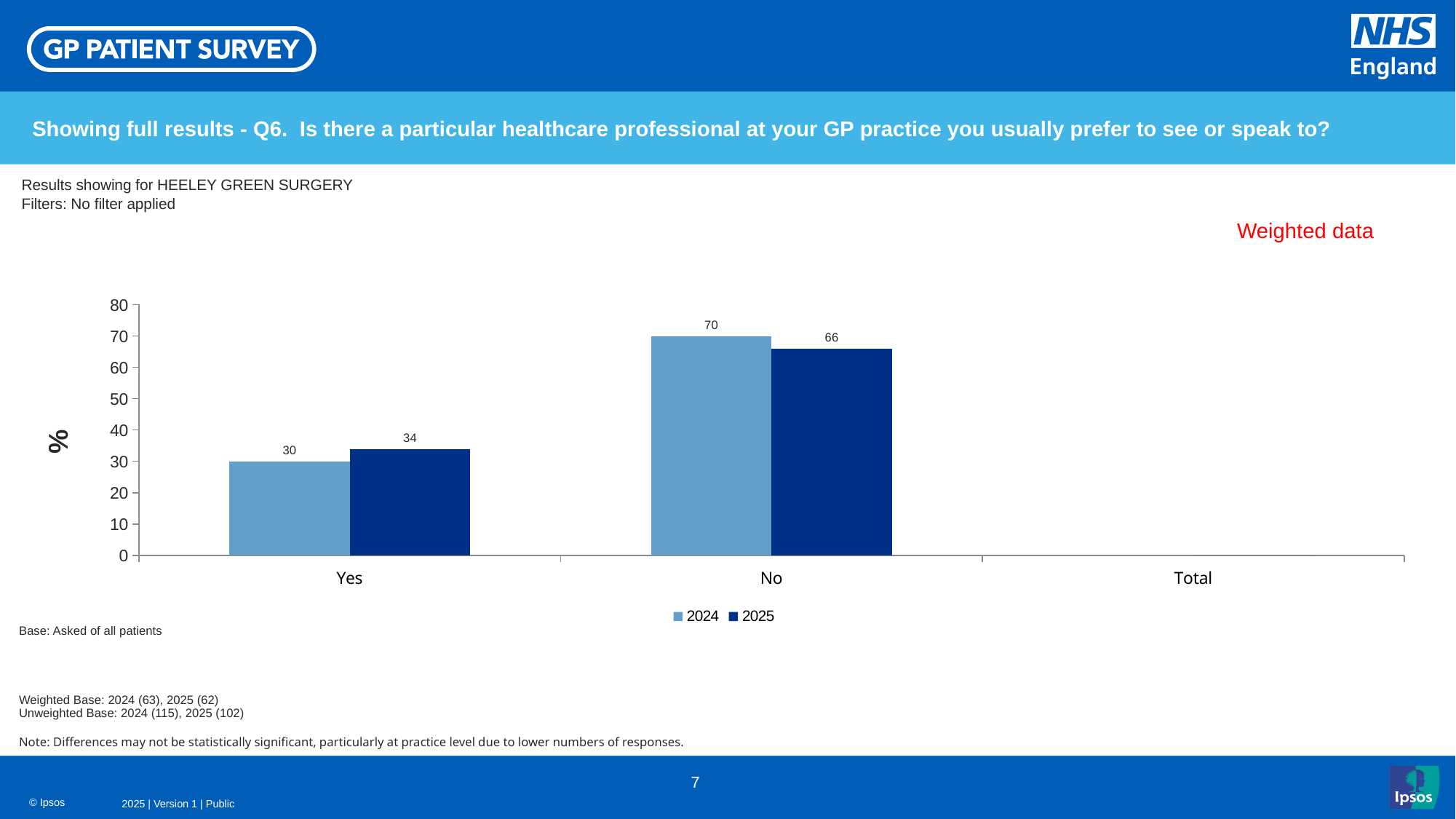
What is the label on the vertical axis of the chart? % What is the value for 'Yes' in 2024? 30 What is the difference between the 2025 values for 'No' and 'Yes'? 32 Which is larger for 'Yes': the 2024 value or the 2025 value? 2025 Which category has the highest value in the 2025 series? No Which category has the lowest value in the 2024 series? Yes What is the value for 'Yes' in 2025? 34 What is the value for 'No' in 2025? 66 What is the difference between the 2024 and 2025 values for 'No'? 4 What is the value for 'No' in 2024? 70 What kind of chart is shown on the slide? Bar chart How many series does the legend list? 2